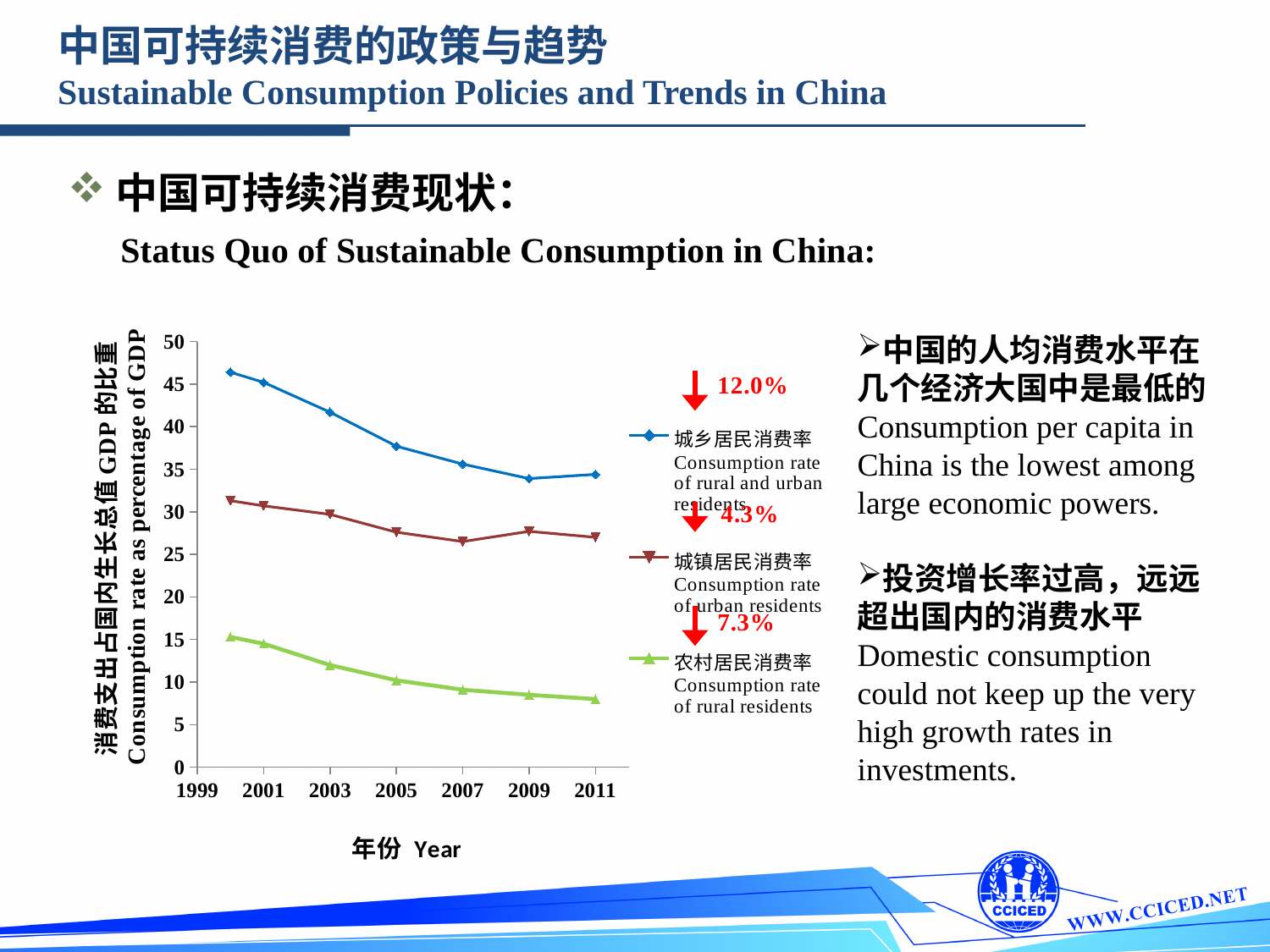
What percentage decline is annotated next to the consumption rate of rural and urban residents series? 12.0% Do the values for the consumption rate of rural residents rise or fall along the x axis? fall In 2011, which is larger: the consumption rate of urban residents or the consumption rate of rural residents? Consumption rate of urban residents What kind of chart is shown on the slide? line chart Which series has the highest values throughout the chart? Consumption rate of rural and urban residents Is the value for the consumption rate of rural and urban residents in 2000 greater or less than 45? greater Which series has the lowest values throughout the chart? Consumption rate of rural residents Do the values for the consumption rate of rural and urban residents rise or fall from 2000 to 2011? fall Is the value for the consumption rate of urban residents in 2011 greater or less than 30? less How many series does the chart's legend list? 3 Is the value for the consumption rate of rural residents in 2011 greater or less than 10? less